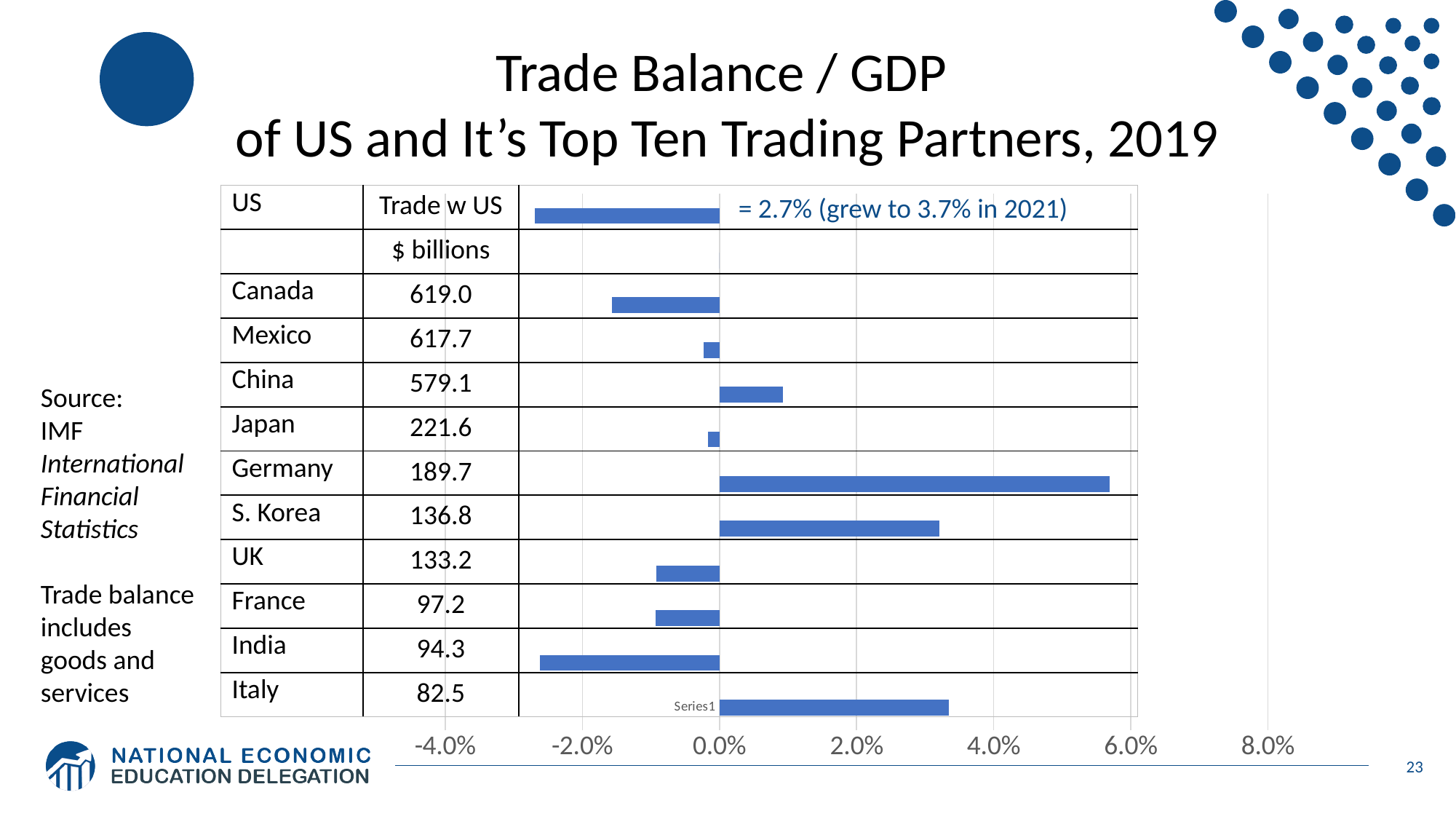
According to the table next to the chart, what is Canada's trade with the US in $ billions? 619.0 Is the trade balance / GDP bar for S. Korea greater or less than 2.0%? greater Is the trade balance / GDP bar for Germany greater or less than 4.0%? greater Is the trade balance / GDP bar for Canada greater or less than 0.0%? less What is the title of the slide containing the chart? Trade Balance / GDP of US and It's Top Ten Trading Partners, 2019 How many countries (including the US) have bars in the chart? 11 What kind of chart is shown on the slide? bar chart Which country has the highest trade balance / GDP bar in the chart? Germany Which has the larger trade balance / GDP bar, Germany or S. Korea? Germany Which has the larger trade balance / GDP bar, Italy or Canada? Italy